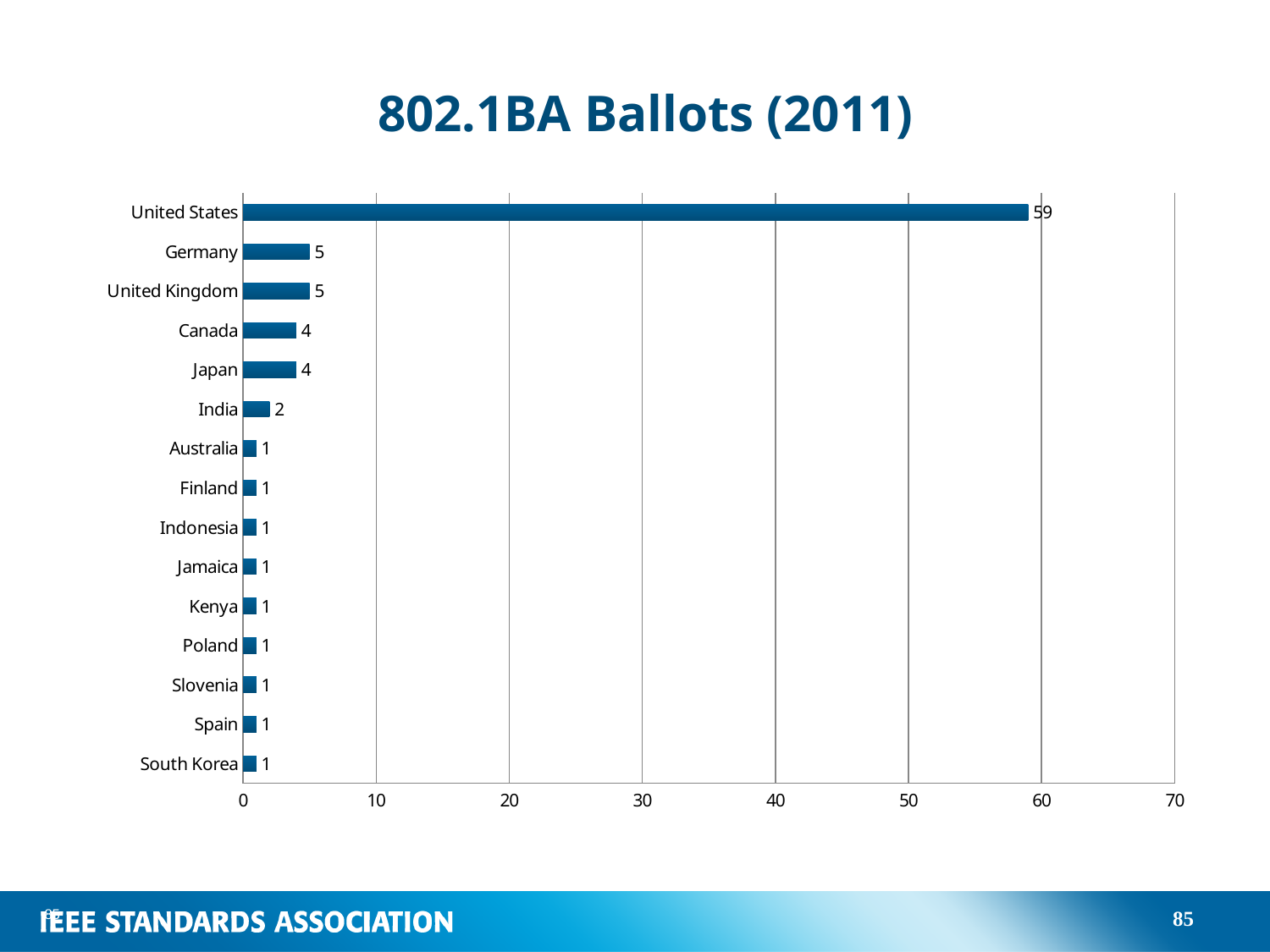
What kind of chart is shown on the slide? bar chart What is the value for Germany? 5 What is the difference between the values for United States and Germany? 54 What is the value for United States? 59 What is the value for India? 2 What is the value for Japan? 4 Which country has the highest value? United States What is the difference between the values for Canada and India? 2 Which is larger, the value for United Kingdom or the value for Canada? United Kingdom How many countries are shown in the chart? 15 Is the value for United States greater or less than 50? greater What is the title of the chart? 802.1BA Ballots (2011)